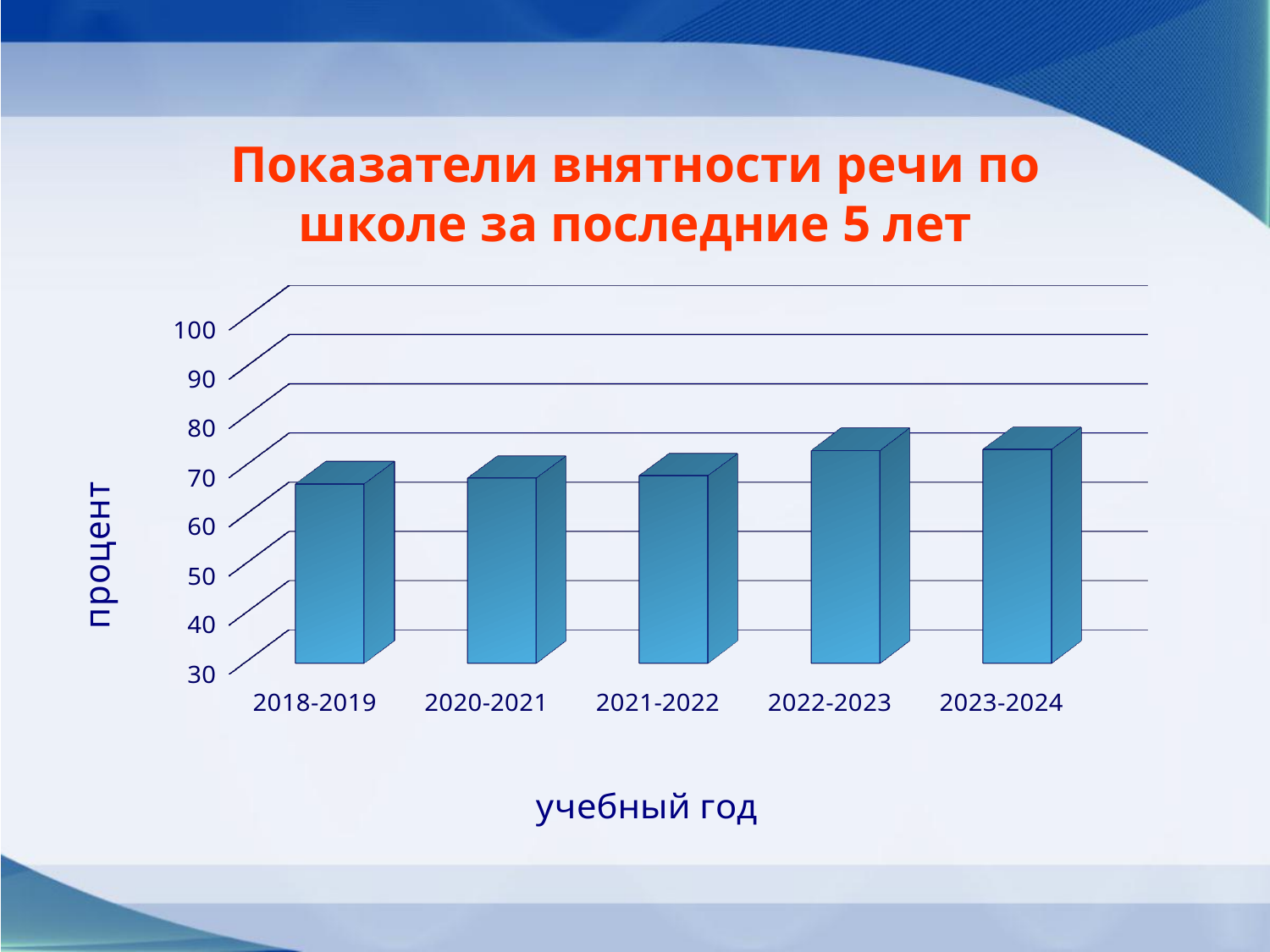
Is the value for 2023-2024 greater or less than 60? greater What kind of chart is shown on the slide? bar chart Is the value for 2021-2022 greater or less than 50? greater Is the value for 2022-2023 greater or less than 90? less Which is larger, the value for 2020-2021 or the value for 2023-2024? 2023-2024 What is the title of the chart? Показатели внятности речи по школе за последние 5 лет Which is larger, the value for 2018-2019 or the value for 2022-2023? 2022-2023 Do the values generally rise or fall from 2018-2019 to 2023-2024? rise What is the label of the vertical axis? процент How many academic years (categories) are plotted on the chart? 5